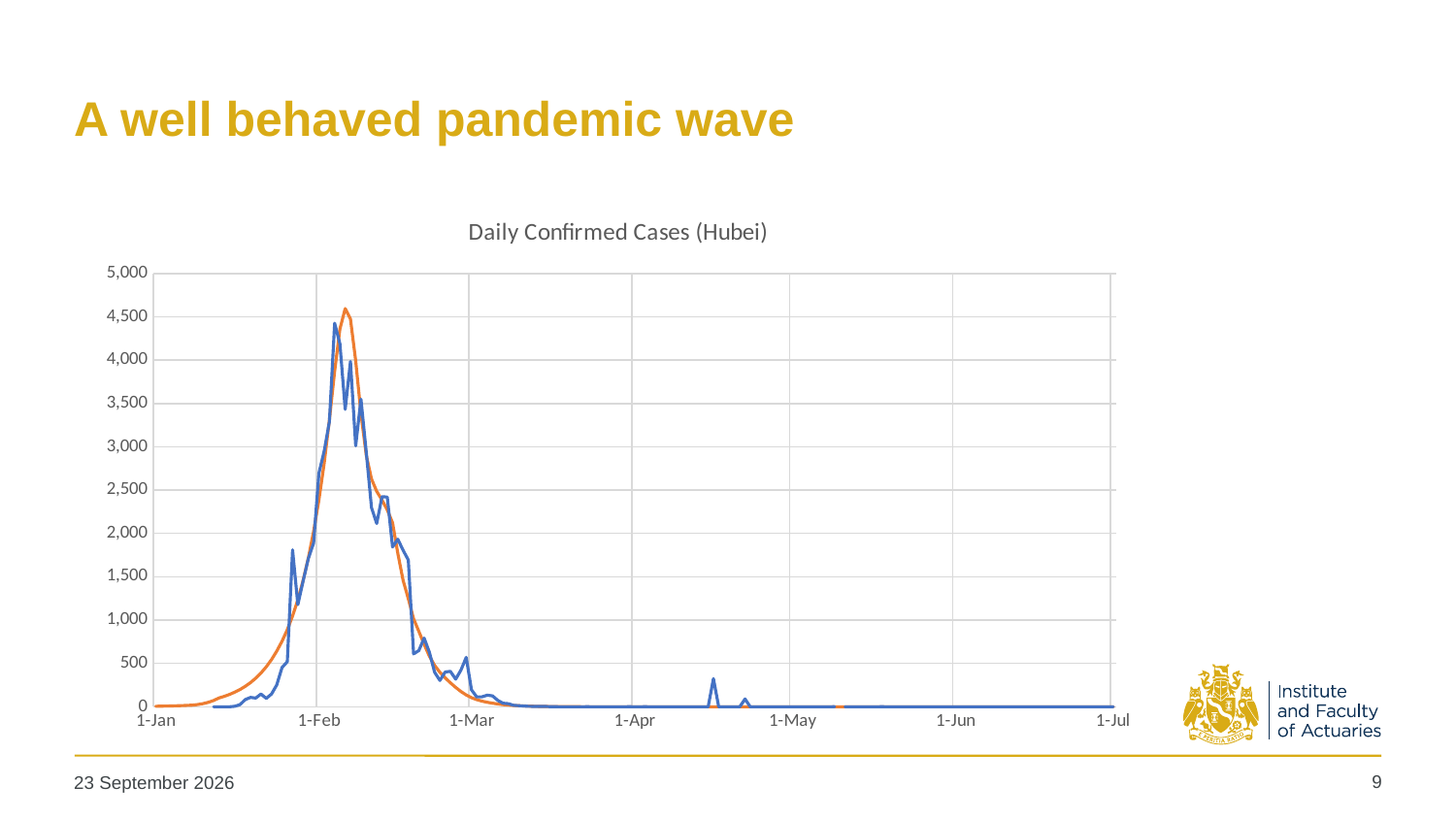
Is the peak value of the orange line greater or less than 4,000? greater Between which two x-axis dates does the peak of the chart occur? 1-Feb and 1-Mar Do the values rise or fall between 1-Jan and 1-Feb? rise What kind of chart is shown on the slide? line chart How many date labels are shown on the x axis? 7 Do the values rise or fall between the peak in early February and 1-Mar? fall Is the peak value of the blue line greater or less than 4,000? greater Is the value of the blue line at 1-Jun greater or less than 500? less What is the title of the chart? Daily Confirmed Cases (Hubei) How many lines are plotted on the chart? 2 What is the highest value shown on the y axis? 5,000